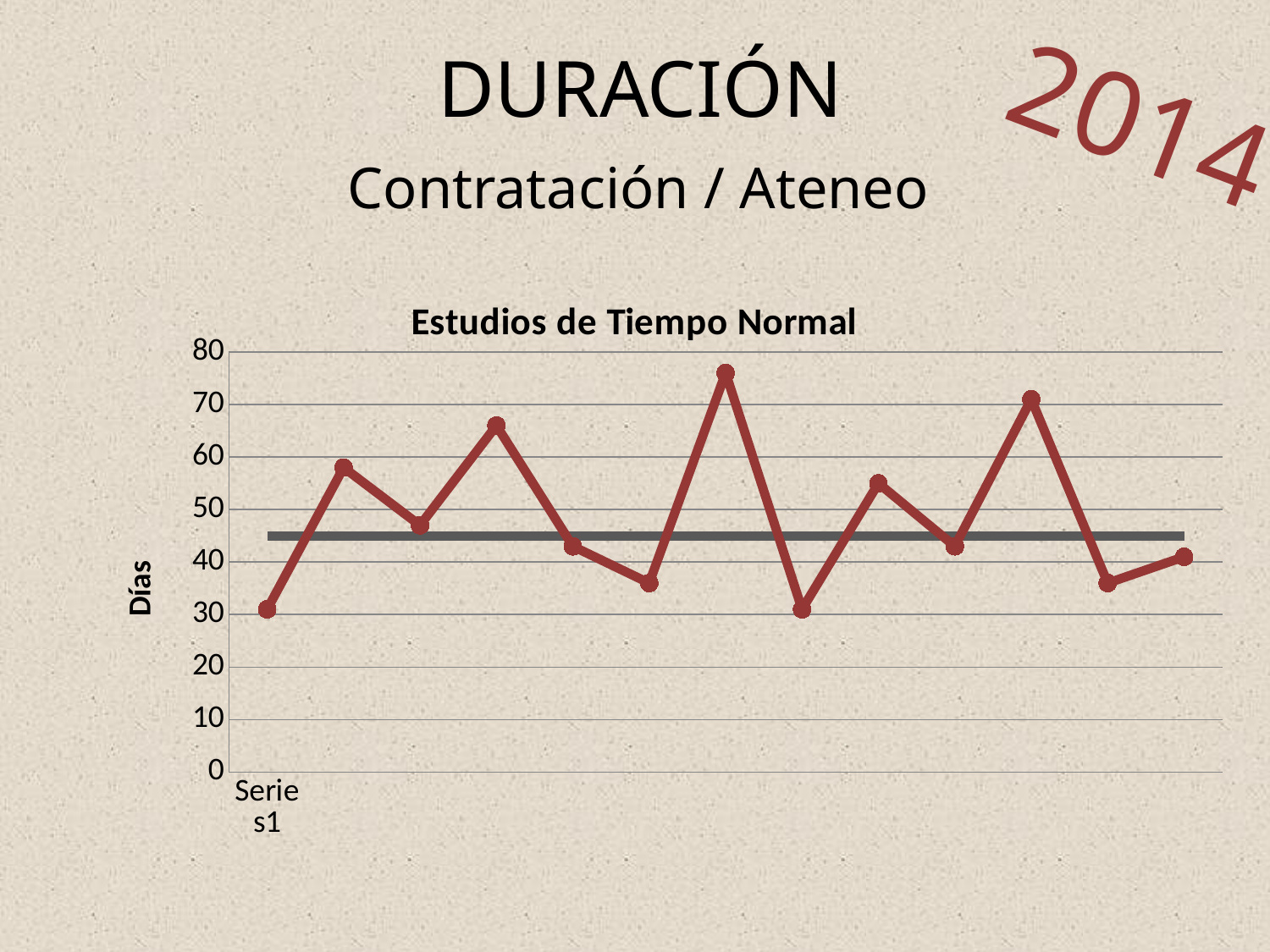
Is the value of the first point on the red line greater or less than 40? less What is the title of the chart? Estudios de Tiempo Normal What is the highest value shown on the vertical axis? 80 What is the label on the vertical axis of the chart? Días What kind of chart is shown on the slide? line chart Is the value of the highest point on the red line greater or less than 70? greater How many data points are plotted on the red line? 13 Is the value of the last point on the red line greater or less than 50? less Which point on the red line has the highest value: the seventh point or the eleventh point? the seventh point